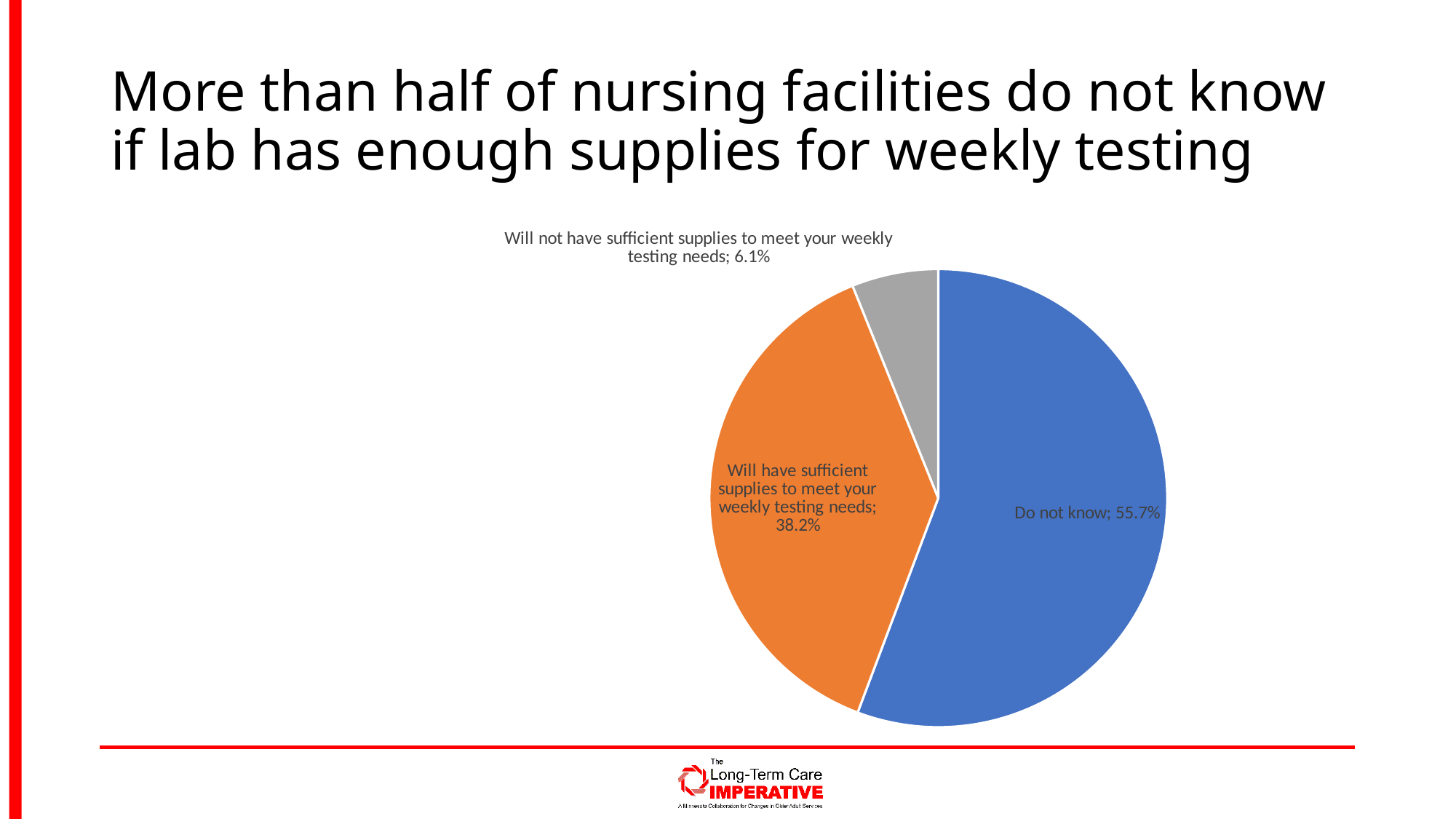
Which category has the smallest share of the pie? Will not have sufficient supplies to meet your weekly testing needs What percentage of nursing facilities will not have sufficient supplies to meet their weekly testing needs? 6.1% What percentage of nursing facilities will have sufficient supplies to meet their weekly testing needs? 38.2% Which category has the largest share of the pie? Do not know What colour is the slice for "Will not have sufficient supplies to meet your weekly testing needs"? grey What percentage of nursing facilities answered "Do not know"? 55.7% What is the difference in percentage points between "Will have sufficient supplies to meet your weekly testing needs" and "Will not have sufficient supplies to meet your weekly testing needs"? 32.1 What is the difference in percentage points between "Do not know" and "Will have sufficient supplies to meet your weekly testing needs"? 17.5 How many slices does the pie chart have? 3 What colour is the "Do not know" slice? blue Which is larger: the share for "Do not know" or the share for "Will have sufficient supplies to meet your weekly testing needs"? Do not know What kind of chart is shown on the slide? pie chart